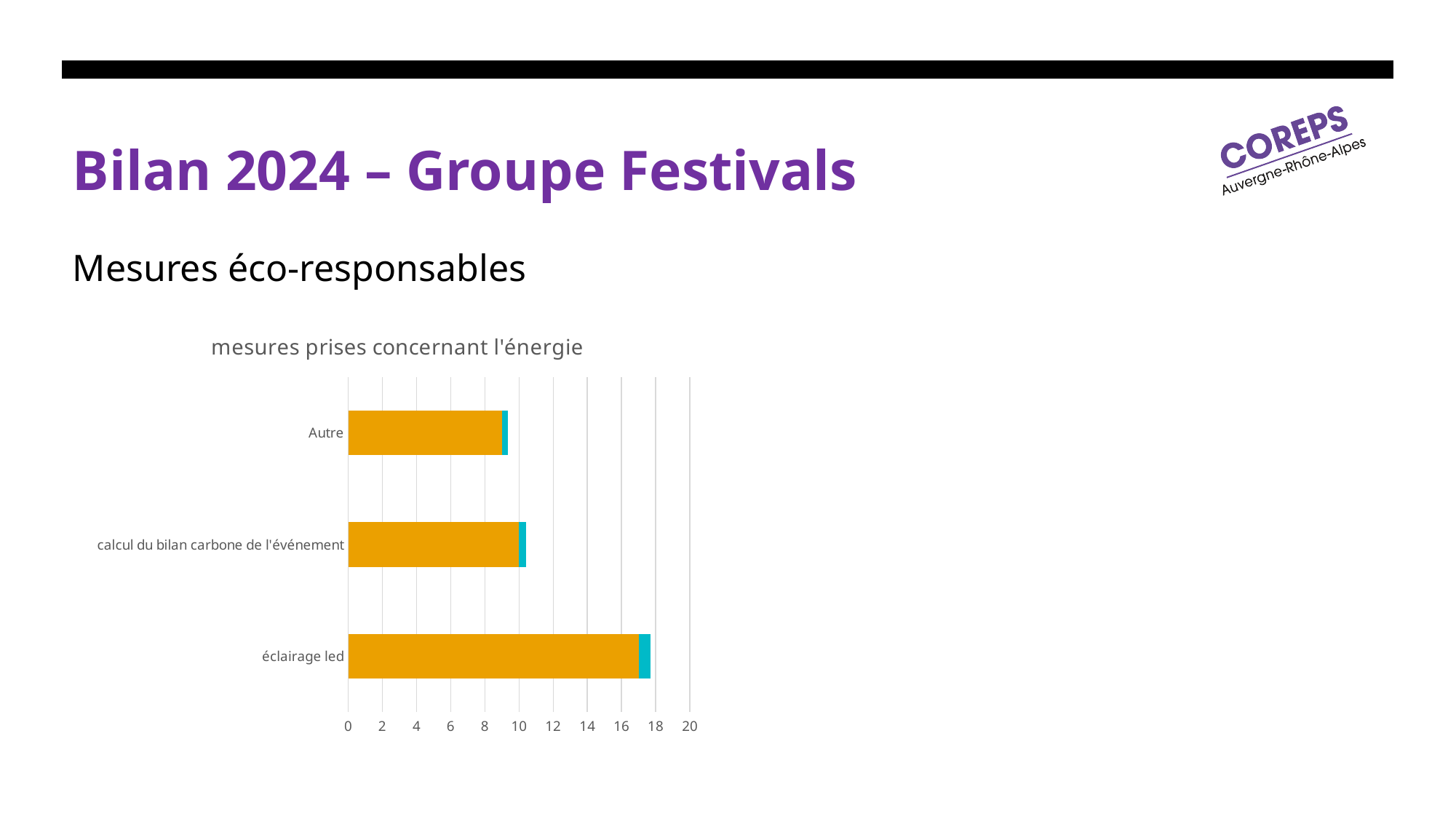
Which is larger, the value for éclairage led or the value for Autre? éclairage led What type of chart is shown on the slide? bar chart Which category has the lowest value? Autre Which category has the highest value? éclairage led Is the value for Autre greater or less than 10? less Is the value for éclairage led greater or less than 20? less What is the title of the chart? mesures prises concernant l'énergie Is the value for éclairage led greater or less than 16? greater How many categories are shown in the chart? 3 Which is larger, the value for éclairage led or the value for calcul du bilan carbone de l'événement? éclairage led What is the maximum value shown on the horizontal axis of the chart? 20